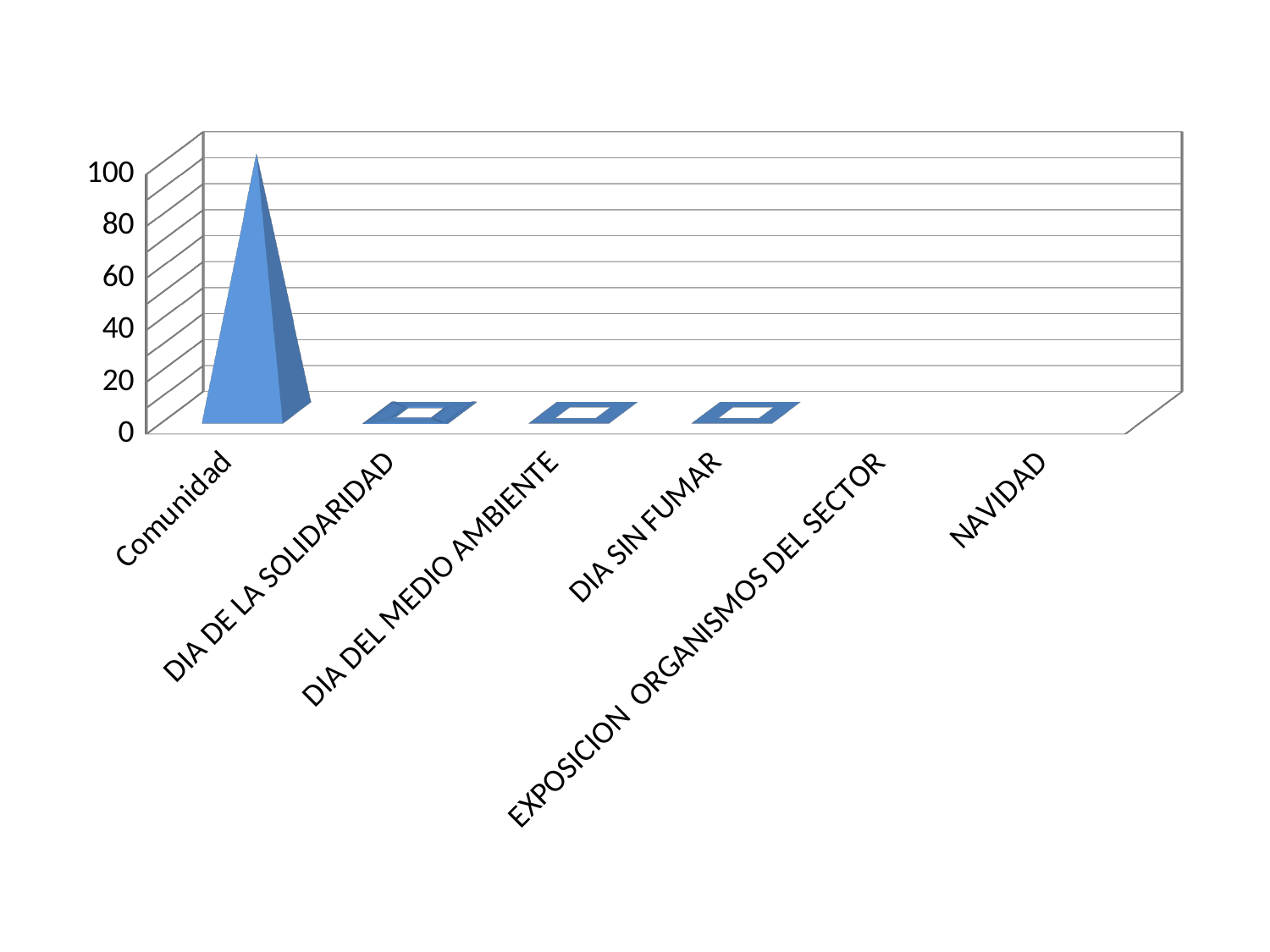
Which is larger, the value for Comunidad or the value for DIA SIN FUMAR? Comunidad How many categories are shown on the x axis of the chart? 6 What is the label of the first category on the x axis? Comunidad Which category has the highest value in the chart? Comunidad What kind of chart is shown on the slide? bar chart Which is larger, the value for Comunidad or the value for DIA DEL MEDIO AMBIENTE? Comunidad What is the highest tick value shown on the vertical axis? 100 Is the value for DIA SIN FUMAR greater or less than 20? less Is the value for DIA DE LA SOLIDARIDAD greater or less than 20? less Is the value for Comunidad greater or less than 80? greater